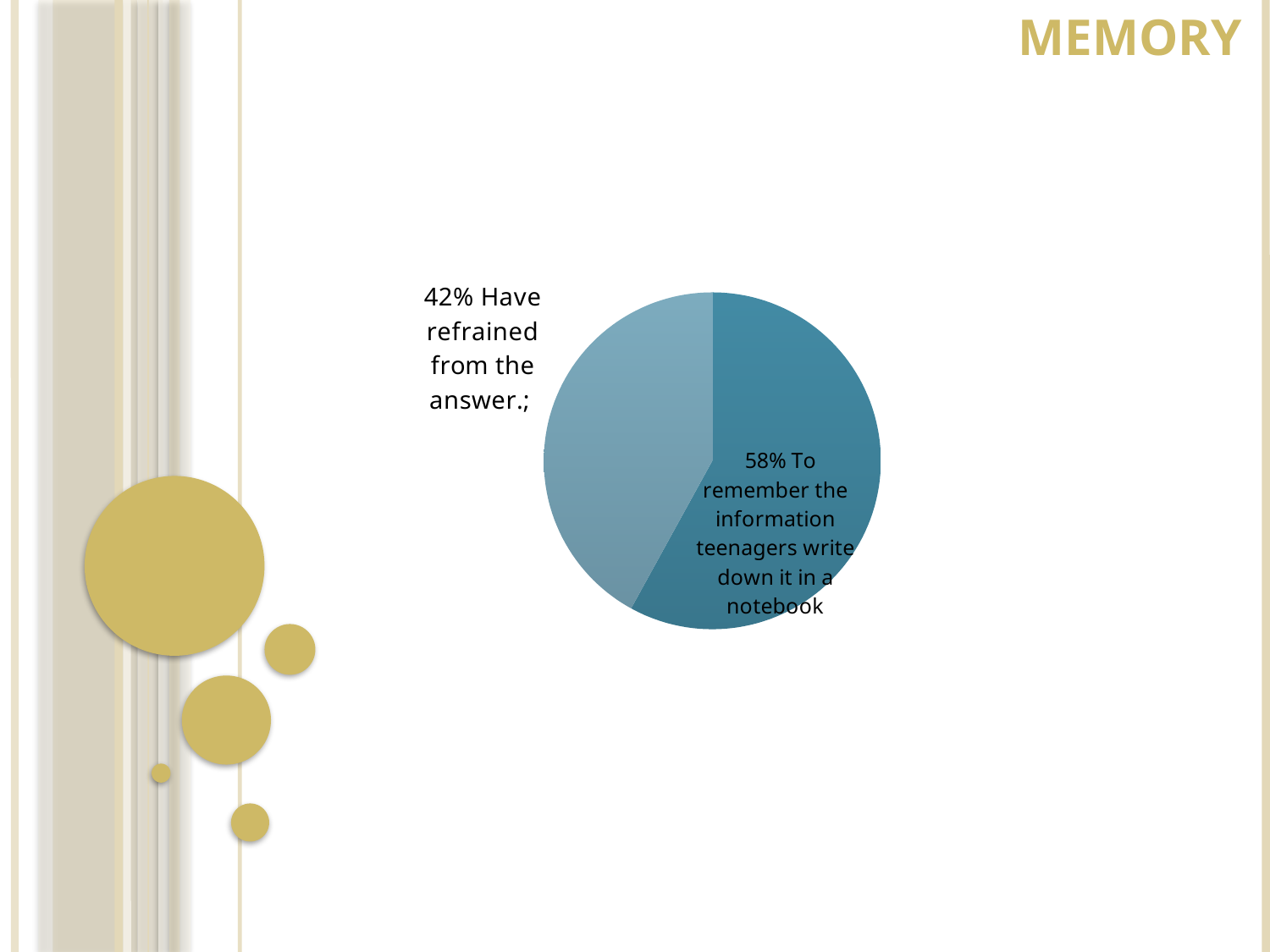
Which slice is the largest in the pie chart? To remember the information teenagers write down it in a notebook Which slice is the smallest in the pie chart? Have refrained from the answer What is the total of the two slices shown in the pie chart? 100% What is the difference in percentage points between the two slices of the pie chart? 16 What kind of chart is shown on the slide? pie chart Which is larger: the share for "Have refrained from the answer" or the share for "To remember the information teenagers write down it in a notebook"? To remember the information teenagers write down it in a notebook Is the share for "Have refrained from the answer" greater or less than 50%? less What share of the pie is labelled "To remember the information teenagers write down it in a notebook"? 58% What share of the pie is labelled "Have refrained from the answer"? 42% What is the title shown at the top of the slide? MEMORY How many slices does the pie chart have? 2